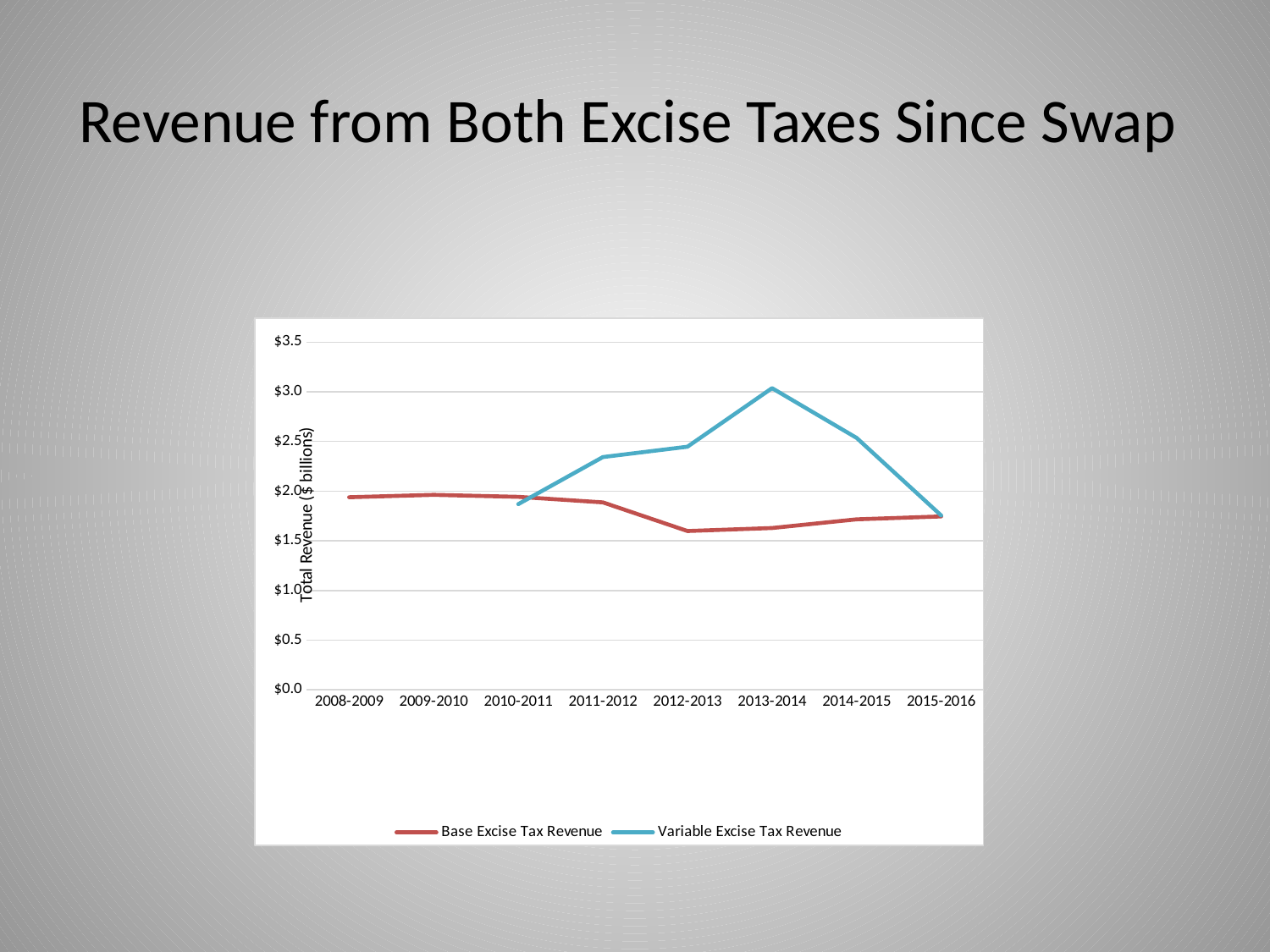
How many fiscal years are shown along the x axis? 8 What is the label on the vertical axis of the chart? Total Revenue ($ billions) What is the title of the chart on the slide? Revenue from Both Excise Taxes Since Swap What kind of chart is shown on the slide? line chart Which series has the higher value in 2013-2014, Base Excise Tax Revenue or Variable Excise Tax Revenue? Variable Excise Tax Revenue In which fiscal year does Variable Excise Tax Revenue reach its highest value? 2013-2014 Does Variable Excise Tax Revenue rise or fall from 2013-2014 to 2015-2016? fall In which fiscal year is Base Excise Tax Revenue at its lowest? 2012-2013 How many series does the legend list? 2 Is the Base Excise Tax Revenue for 2012-2013 greater or less than $2.0 billion? less Is the Variable Excise Tax Revenue for 2011-2012 greater or less than $2.0 billion? greater Is the Variable Excise Tax Revenue for 2013-2014 greater or less than $2.5 billion? greater